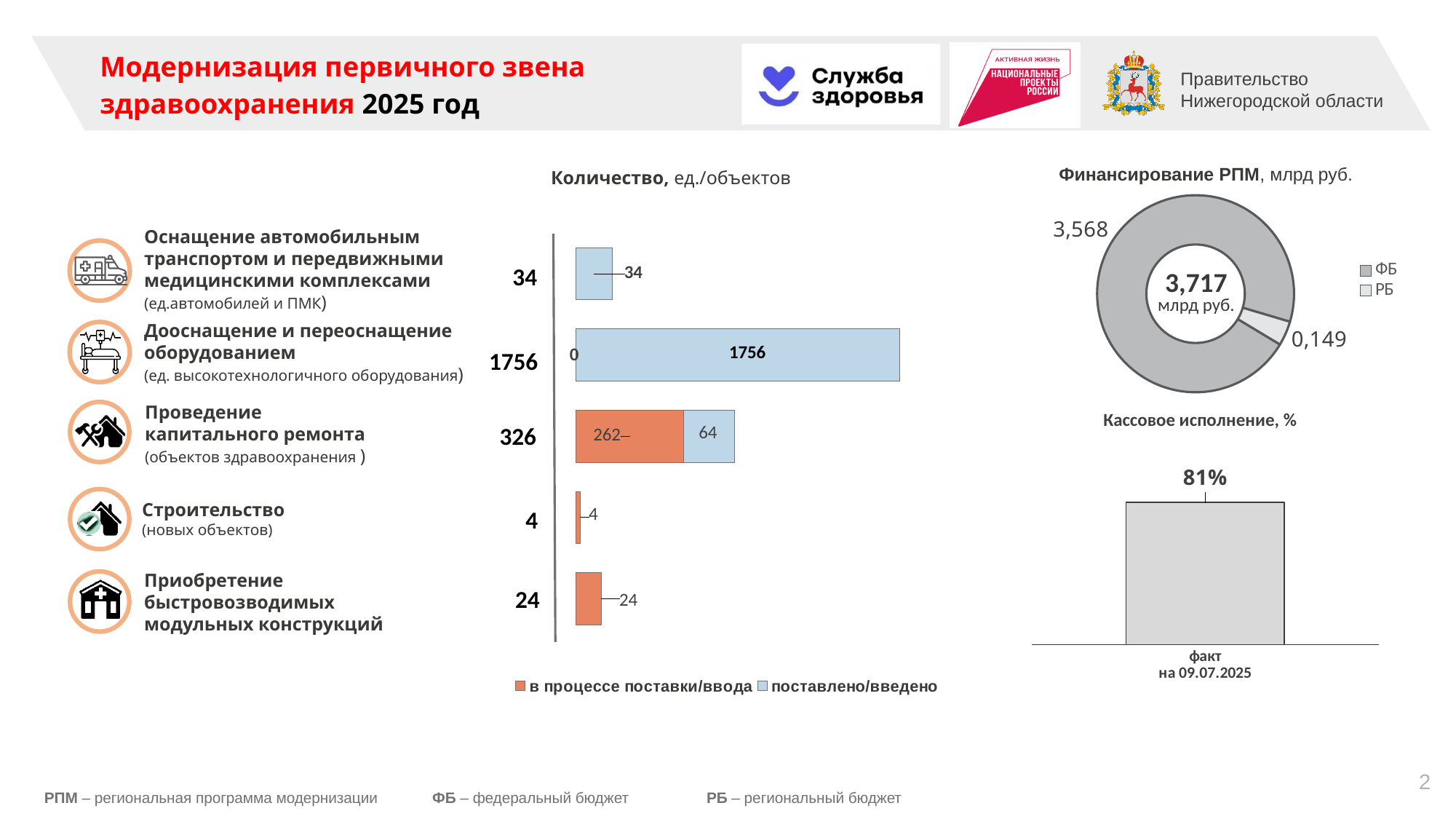
In the 'Количество, ед./объектов' chart, what is the value of 'поставлено/введено' for 'Дооснащение и переоснащение оборудованием'? 1756 In the 'Количество, ед./объектов' chart, how many categories are shown? 5 In the 'Количество, ед./объектов' chart, how many series does the legend list? 2 In the 'Кассовое исполнение, %' chart, what is the value for 'факт на 09.07.2025'? 81% In the 'Количество, ед./объектов' chart, which category has the lowest total value? Строительство In the 'Количество, ед./объектов' chart, which category has the highest total value? Дооснащение и переоснащение оборудованием In the 'Количество, ед./объектов' chart, what is the value of 'в процессе поставки/ввода' for 'Проведение капитального ремонта'? 262 What kind of chart is 'Финансирование РПМ, млрд руб.'? Donut (pie) chart In the 'Финансирование РПМ, млрд руб.' chart, what is the value for ФБ? 3,568 In the 'Количество, ед./объектов' chart, what is the difference between 'в процессе поставки/ввода' and 'поставлено/введено' for 'Проведение капитального ремонта'? 198 In the 'Количество, ед./объектов' chart, what is the total for 'Проведение капитального ремонта'? 326 In the 'Финансирование РПМ, млрд руб.' chart, which is larger, ФБ or РБ? ФБ